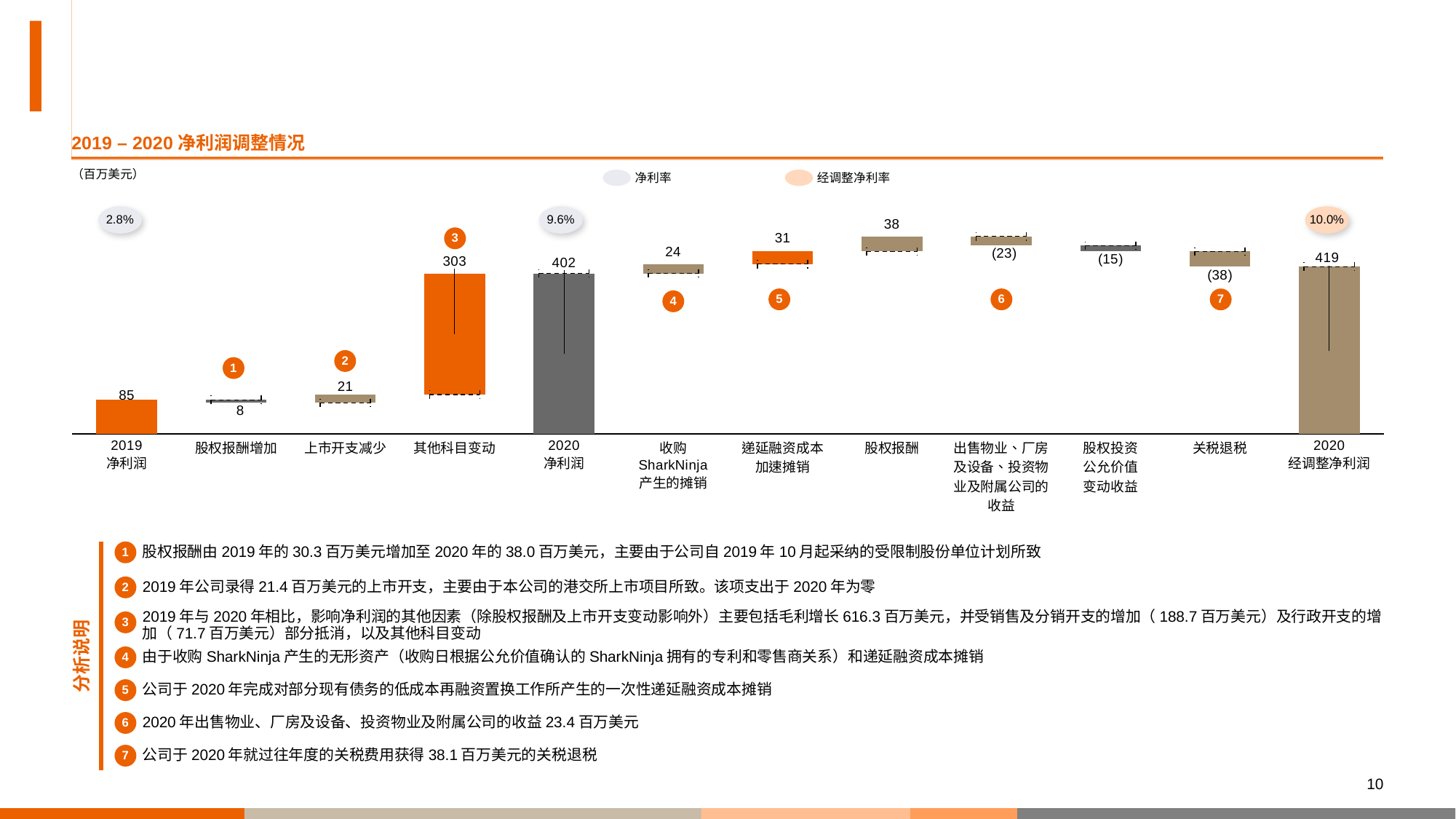
What is the value shown for 股权投资公允价值变动收益? (15) How many categories are shown on the x axis? 12 What is the 净利率 shown for 2019 净利润? 2.8% What is the value for 2020 经调整净利润? 419 Which is larger, the value for 递延融资成本加速摊销 or the value for 收购 SharkNinja 产生的摊销? 递延融资成本加速摊销 What is the 经调整净利率 shown for 2020 经调整净利润? 10.0% What is the value for 其他科目变动? 303 What is the value shown for 关税退税? (38) What is the difference between 2020 经调整净利润 and 2020 净利润? 17 Which category has the highest bar value? 2020 经调整净利润 What is the value for 2020 净利润? 402 What is the value for 2019 净利润? 85